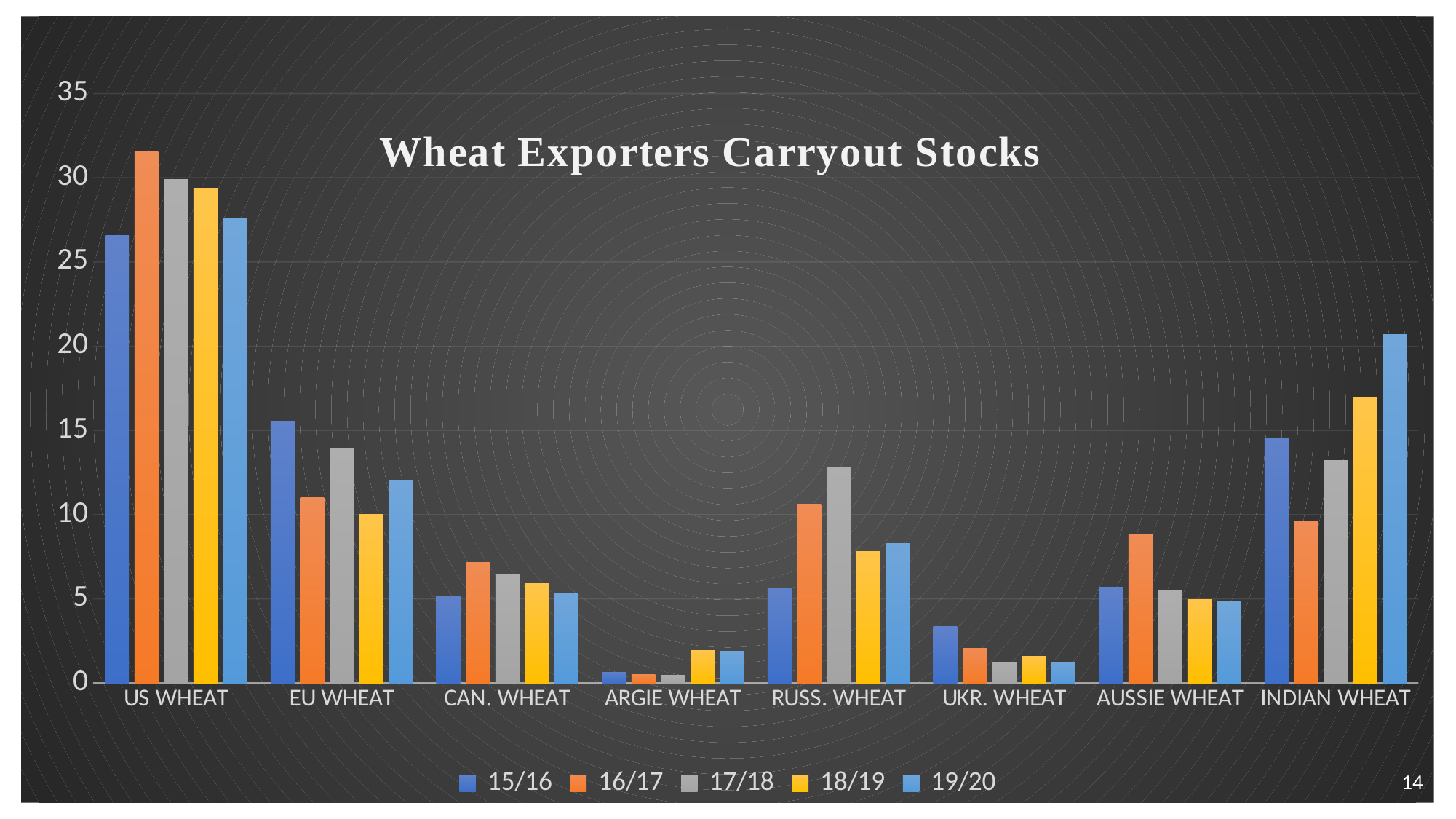
What kind of chart is shown on the slide? bar chart For RUSS. WHEAT, which is larger: the 17/18 value or the 18/19 value? 17/18 How many wheat exporter categories are shown on the x axis? 8 Is the 16/17 value for US WHEAT greater or less than 30? greater Which category has the highest 16/17 bar? US WHEAT Is the 19/20 value for INDIAN WHEAT greater or less than 15? greater Is the 18/19 value for ARGIE WHEAT greater or less than 5? less What is the title of the chart? Wheat Exporters Carryout Stocks For INDIAN WHEAT, do the values rise or fall from 17/18 to 19/20? rise For EU WHEAT, which is larger: the 15/16 value or the 16/17 value? 15/16 How many series does the legend list? 5 Which category has the lowest 15/16 bar? ARGIE WHEAT